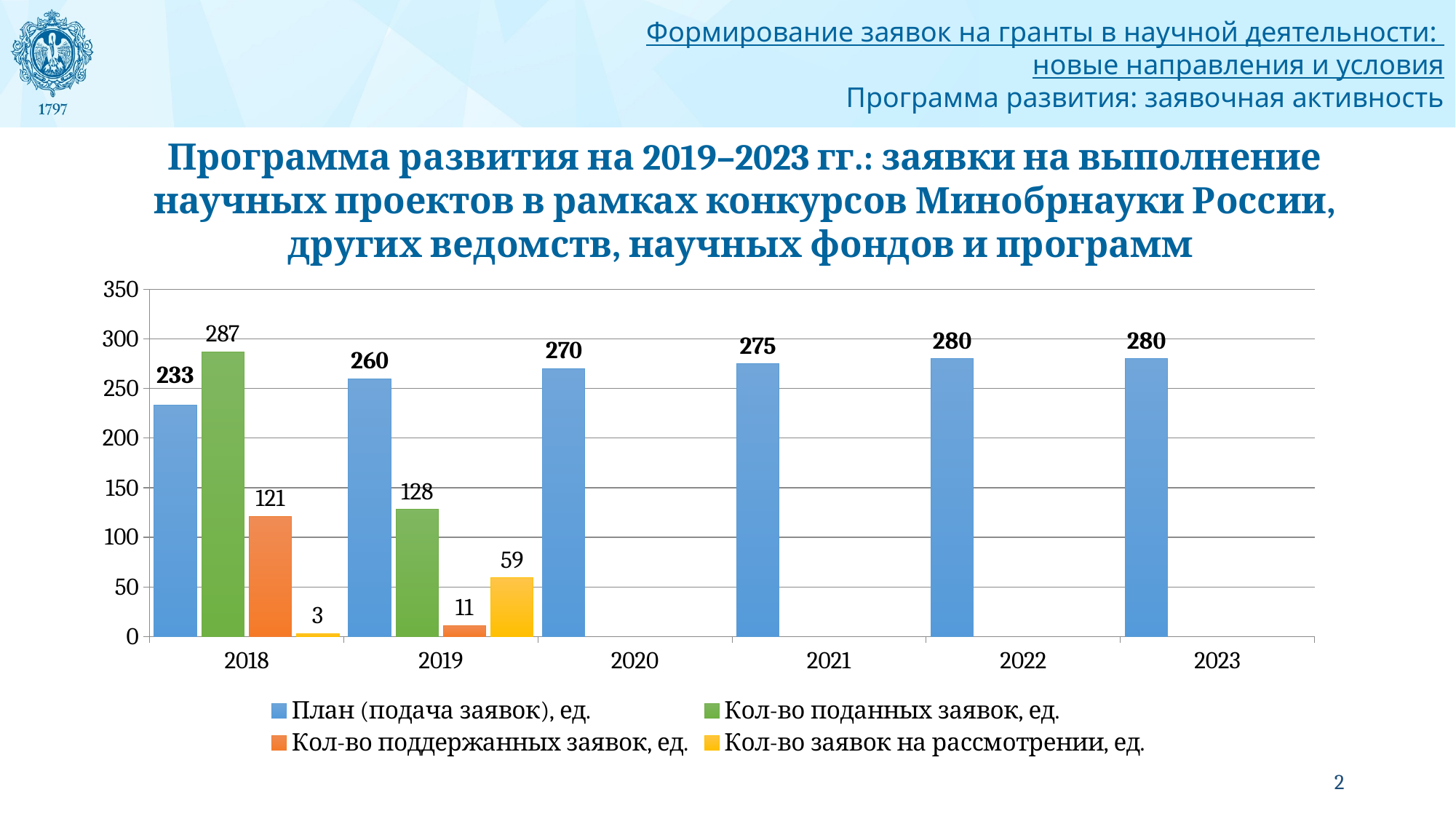
What kind of chart is shown on the slide? bar chart Is the value of "План (подача заявок), ед." for 2020 greater or less than 250? greater What is the value of "Кол-во поддержанных заявок, ед." for 2018? 121 How many series does the legend list? 4 Does the "План (подача заявок), ед." series rise or fall from 2018 to 2022? rise In which year is the "План (подача заявок), ед." value the lowest? 2018 Which is larger in 2018: "План (подача заявок), ед." or "Кол-во поданных заявок, ед."? Кол-во поданных заявок, ед. What is the value of "Кол-во поданных заявок, ед." for 2019? 128 How many years are shown on the x axis? 6 What is the difference between "Кол-во поданных заявок, ед." in 2018 and in 2019? 159 What is the value of "Кол-во заявок на рассмотрении, ед." for 2019? 59 What is the value of "План (подача заявок), ед." for 2018? 233